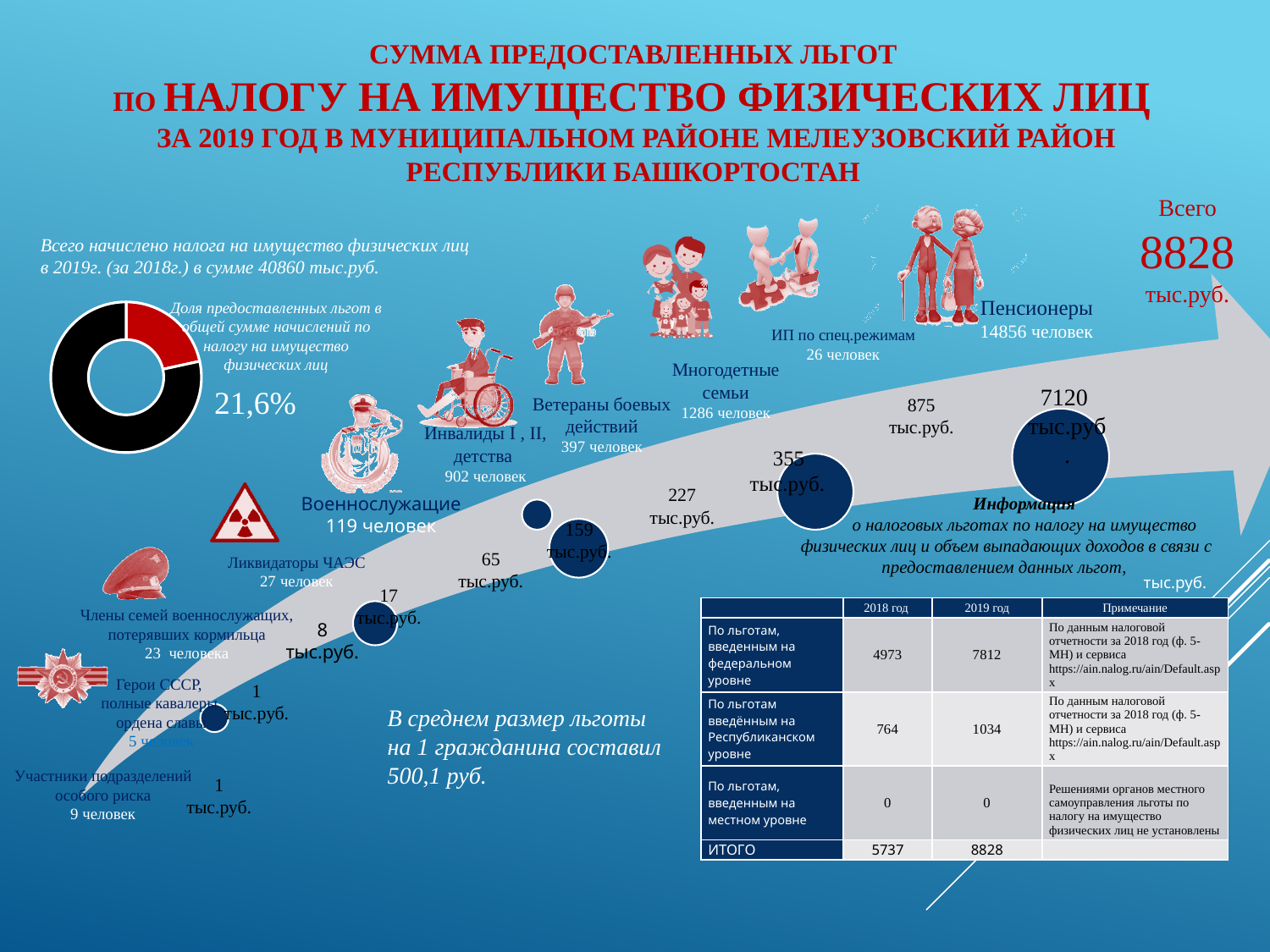
In the arrow infographic, what is the amount of benefits shown for Многодетные семьи? 355 тыс.руб. In the donut chart on the left, what share is shown for the red slice? 21,6% In the donut chart on the left, what colour is the slice labelled 21,6%? red In the arrow infographic, which category has the largest amount of benefits? Пенсионеры In the donut chart on the left, which slice is larger, the red one or the black one? the black one In the arrow infographic, what is the amount of benefits shown for Ветераны боевых действий? 227 тыс.руб. What total amount of benefits (Всего) is shown at the top right of the arrow infographic? 8828 тыс.руб. What kind of chart is the chart on the left of the slide labelled 'Доля предоставленных льгот в общей сумме начислений по налогу на имущество физических лиц'? pie chart (donut) In the arrow infographic, what is the amount of benefits shown for Пенсионеры? 7120 тыс.руб. In the arrow infographic, what is the difference between the benefits for Пенсионеры (7120 тыс.руб.) and for ИП по спец.режимам (875 тыс.руб.)? 6245 тыс.руб. How many slices does the donut chart on the left have? 2 Is the share shown by the red slice in the donut chart on the left greater or less than 50%? less